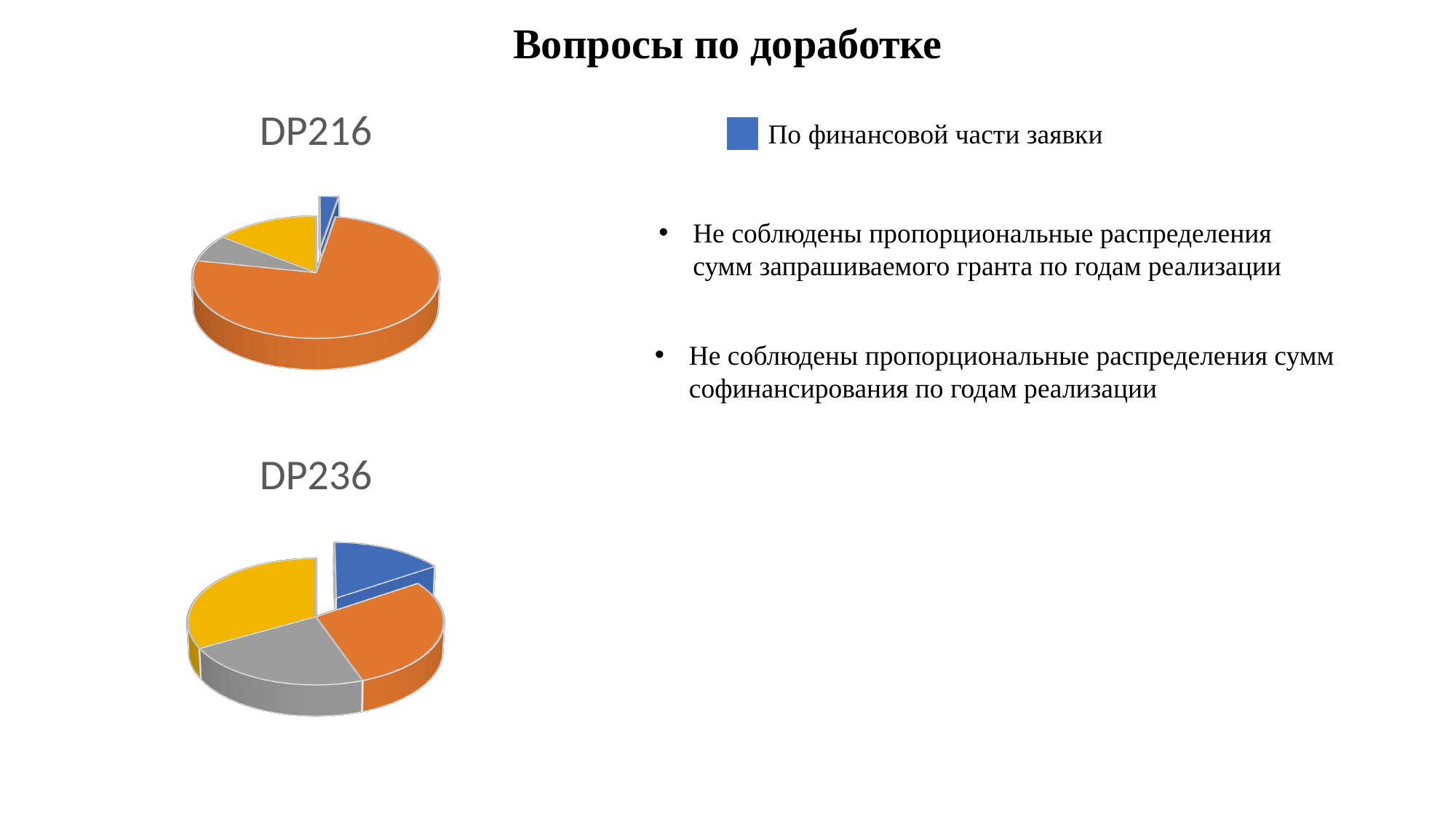
How many slices does the DP236 pie chart have? 4 How many slices does the DP216 pie chart have? 4 What kind of chart is the DP216 chart? pie chart In the DP236 chart, which is larger, the blue slice or the orange slice? orange What kind of chart is the DP236 chart? pie chart According to the slide, what does the blue slice represent? По финансовой части заявки In the DP216 chart, which is larger, the blue slice or the gray slice? gray What is the title of the top pie chart on the slide? DP216 In the DP216 chart, which colour slice is the largest? orange In the DP216 chart, which colour slice is the smallest? blue In the DP236 chart, which colour slice is the smallest? blue In the DP216 chart, which is larger, the orange slice or the yellow slice? orange